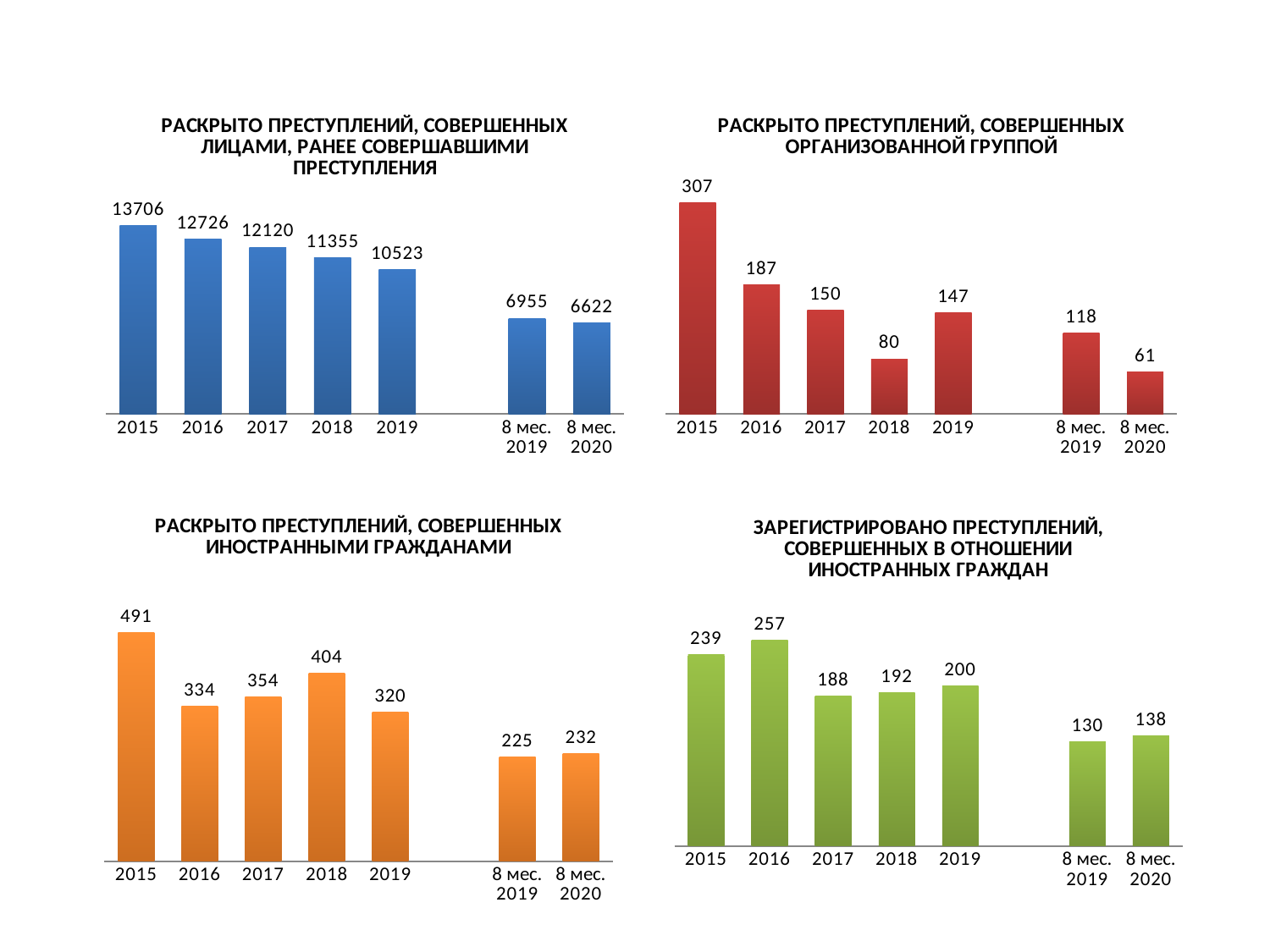
In the bottom-left chart (РАСКРЫТО ПРЕСТУПЛЕНИЙ, СОВЕРШЕННЫХ ИНОСТРАННЫМИ ГРАЖДАНАМИ), what is the difference between the values for 2015 and 2016? 157 What kind of chart is the top-left chart (РАСКРЫТО ПРЕСТУПЛЕНИЙ, СОВЕРШЕННЫХ ЛИЦАМИ, РАНЕЕ СОВЕРШАВШИМИ ПРЕСТУПЛЕНИЯ)? Bar chart In the top-left chart (РАСКРЫТО ПРЕСТУПЛЕНИЙ, СОВЕРШЕННЫХ ЛИЦАМИ, РАНЕЕ СОВЕРШАВШИМИ ПРЕСТУПЛЕНИЯ), what is the value for 2017? 12120 In the bottom-right chart (ЗАРЕГИСТРИРОВАНО ПРЕСТУПЛЕНИЙ, СОВЕРШЕННЫХ В ОТНОШЕНИИ ИНОСТРАННЫХ ГРАЖДАН), what is the value for 2016? 257 In the top-left chart (РАСКРЫТО ПРЕСТУПЛЕНИЙ, СОВЕРШЕННЫХ ЛИЦАМИ, РАНЕЕ СОВЕРШАВШИМИ ПРЕСТУПЛЕНИЯ), what is the difference between the values for 8 мес. 2019 and 8 мес. 2020? 333 How many categories are shown on the x axis of the bottom-right chart (ЗАРЕГИСТРИРОВАНО ПРЕСТУПЛЕНИЙ, СОВЕРШЕННЫХ В ОТНОШЕНИИ ИНОСТРАННЫХ ГРАЖДАН)? 7 In the top-left chart (РАСКРЫТО ПРЕСТУПЛЕНИЙ, СОВЕРШЕННЫХ ЛИЦАМИ, РАНЕЕ СОВЕРШАВШИМИ ПРЕСТУПЛЕНИЯ), which category has the highest value? 2015 In the bottom-right chart (ЗАРЕГИСТРИРОВАНО ПРЕСТУПЛЕНИЙ, СОВЕРШЕННЫХ В ОТНОШЕНИИ ИНОСТРАННЫХ ГРАЖДАН), which is larger, the value for 8 мес. 2019 or 8 мес. 2020? 8 мес. 2020 In the top-right chart (РАСКРЫТО ПРЕСТУПЛЕНИЙ, СОВЕРШЕННЫХ ОРГАНИЗОВАННОЙ ГРУППОЙ), which is larger, the value for 2016 or the value for 2019? 2016 In the top-right chart (РАСКРЫТО ПРЕСТУПЛЕНИЙ, СОВЕРШЕННЫХ ОРГАНИЗОВАННОЙ ГРУППОЙ), what is the value for 2018? 80 In the bottom-left chart (РАСКРЫТО ПРЕСТУПЛЕНИЙ, СОВЕРШЕННЫХ ИНОСТРАННЫМИ ГРАЖДАНАМИ), what is the value for 2018? 404 In the top-right chart (РАСКРЫТО ПРЕСТУПЛЕНИЙ, СОВЕРШЕННЫХ ОРГАНИЗОВАННОЙ ГРУППОЙ), which category has the lowest value? 8 мес. 2020